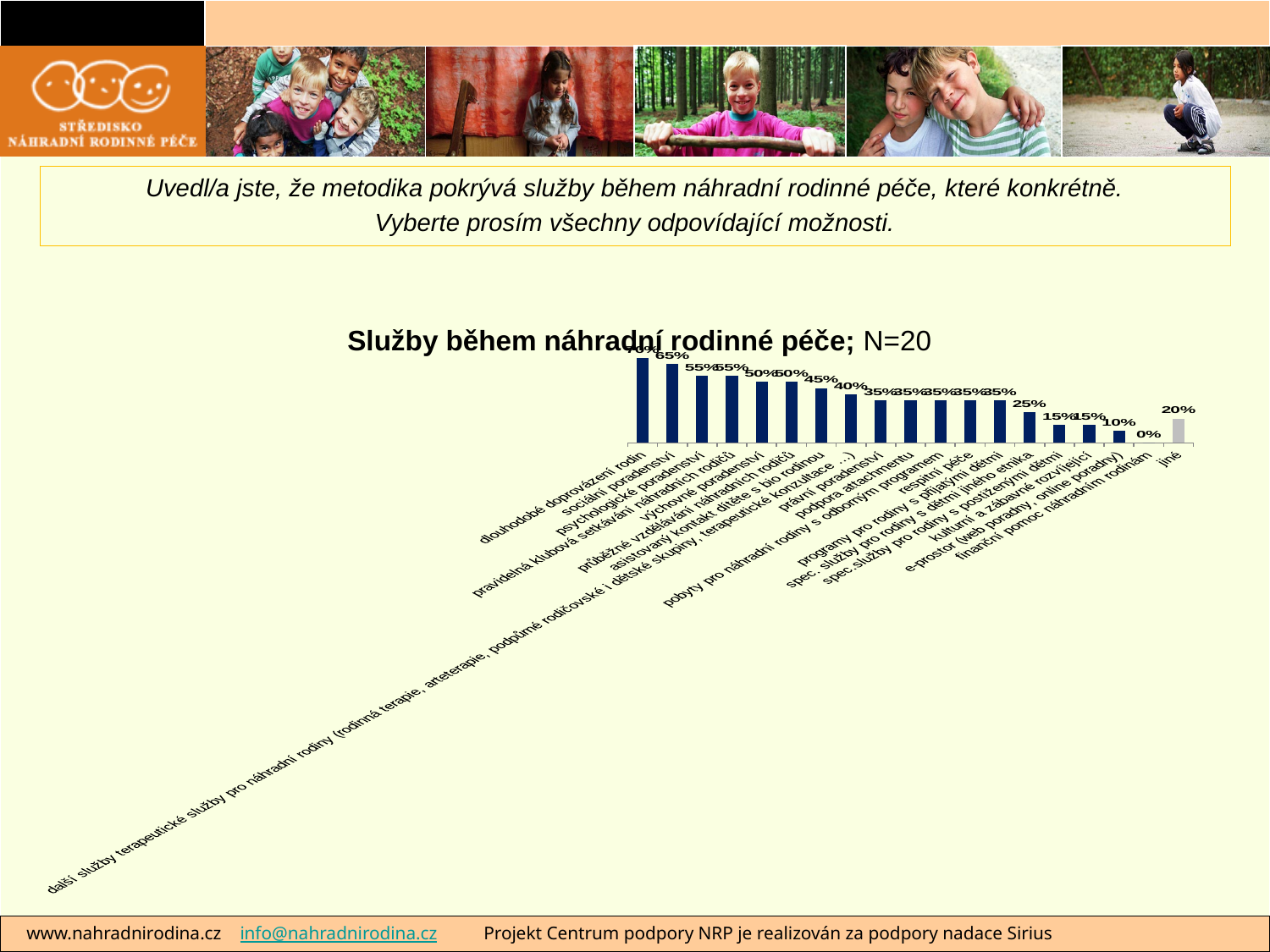
What kind of chart is shown on the slide? bar chart What is the difference between the values for sociální poradenství and právní poradenství? 30% What is the value for jiné? 20% What is the value for spec. služby pro rodiny s postiženými dětmi? 15% What is the difference between the values for jiné and e-prostor (web poradny, online poradny)? 10% What is the value for asistovaný kontakt dítěte s bio rodinou? 45% What is the value for finanční pomoc náhradním rodinám? 0% What is the N value stated in the chart title? 20 Which is larger, the value for výchovné poradenství or the value for podpora attachmentu? výchovné poradenství What is the value for sociální poradenství? 65% Which category has the highest value? dlouhodobé doprovázení rodin What is the value for respitní péče? 35%